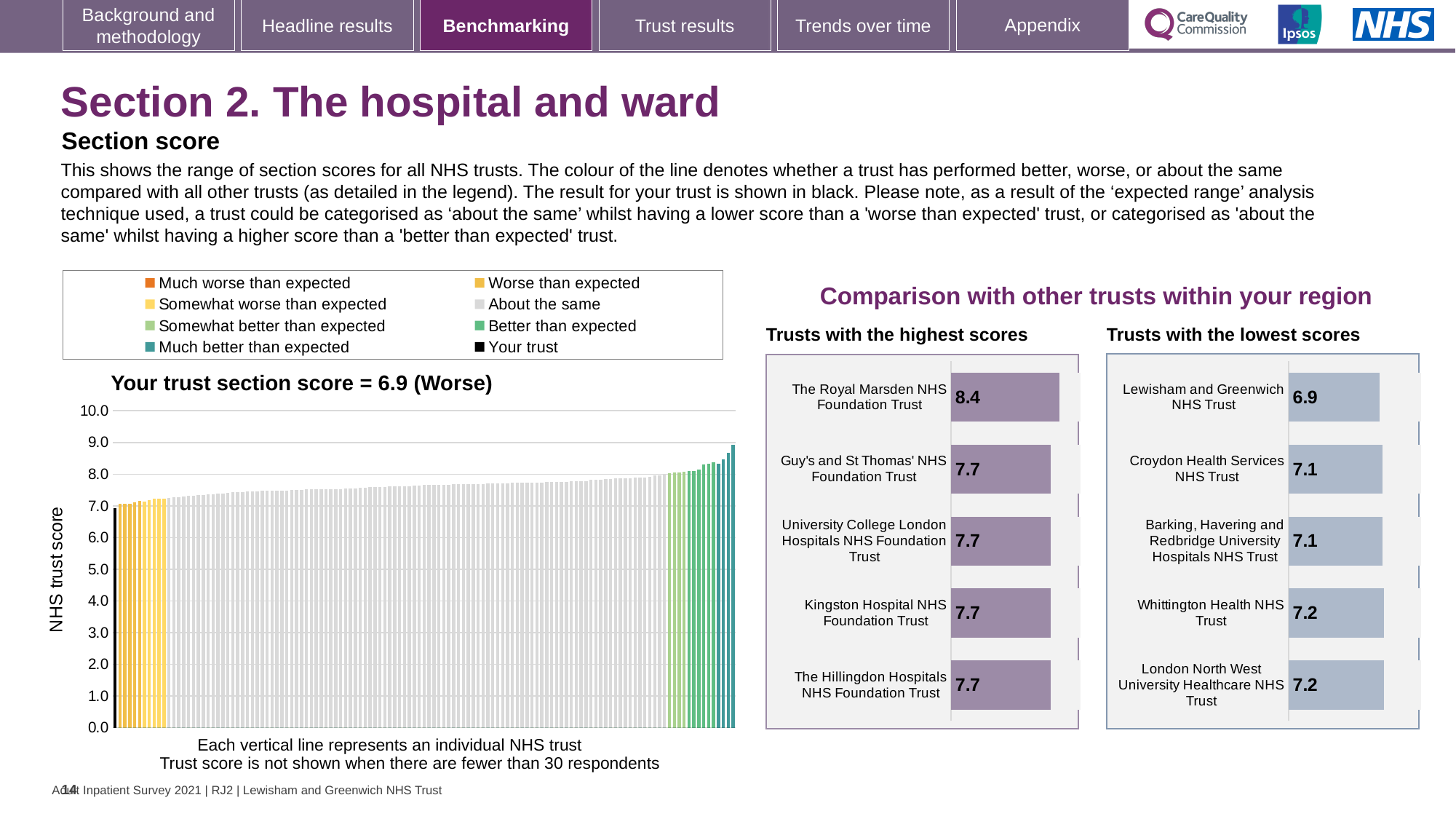
In the 'Your trust section score' chart, is the value of the tallest bar greater or less than 8.0? greater In the 'Your trust section score' chart, do the bar values rise or fall from left to right? rise In the 'Trusts with the lowest scores' chart, which has the larger score: Lewisham and Greenwich NHS Trust or Croydon Health Services NHS Trust? Croydon Health Services NHS Trust How many trusts are listed in the 'Trusts with the highest scores' chart? 5 In the 'Trusts with the highest scores' chart, what is the score for The Royal Marsden NHS Foundation Trust? 8.4 In the 'Trusts with the lowest scores' chart, which trust has the lowest score? Lewisham and Greenwich NHS Trust In the 'Trusts with the lowest scores' chart, what is the score for Whittington Health NHS Trust? 7.2 In the 'Trusts with the lowest scores' chart, what is the score for Croydon Health Services NHS Trust? 7.1 In the 'Trusts with the lowest scores' chart, what is the difference between the scores of London North West University Healthcare NHS Trust and Lewisham and Greenwich NHS Trust? 0.3 In the 'Your trust section score' chart, what is the section score for your trust? 6.9 In the 'Trusts with the highest scores' chart, which trust has the highest score? The Royal Marsden NHS Foundation Trust In the 'Trusts with the highest scores' chart, what is the difference between the scores of The Royal Marsden NHS Foundation Trust and Kingston Hospital NHS Foundation Trust? 0.7